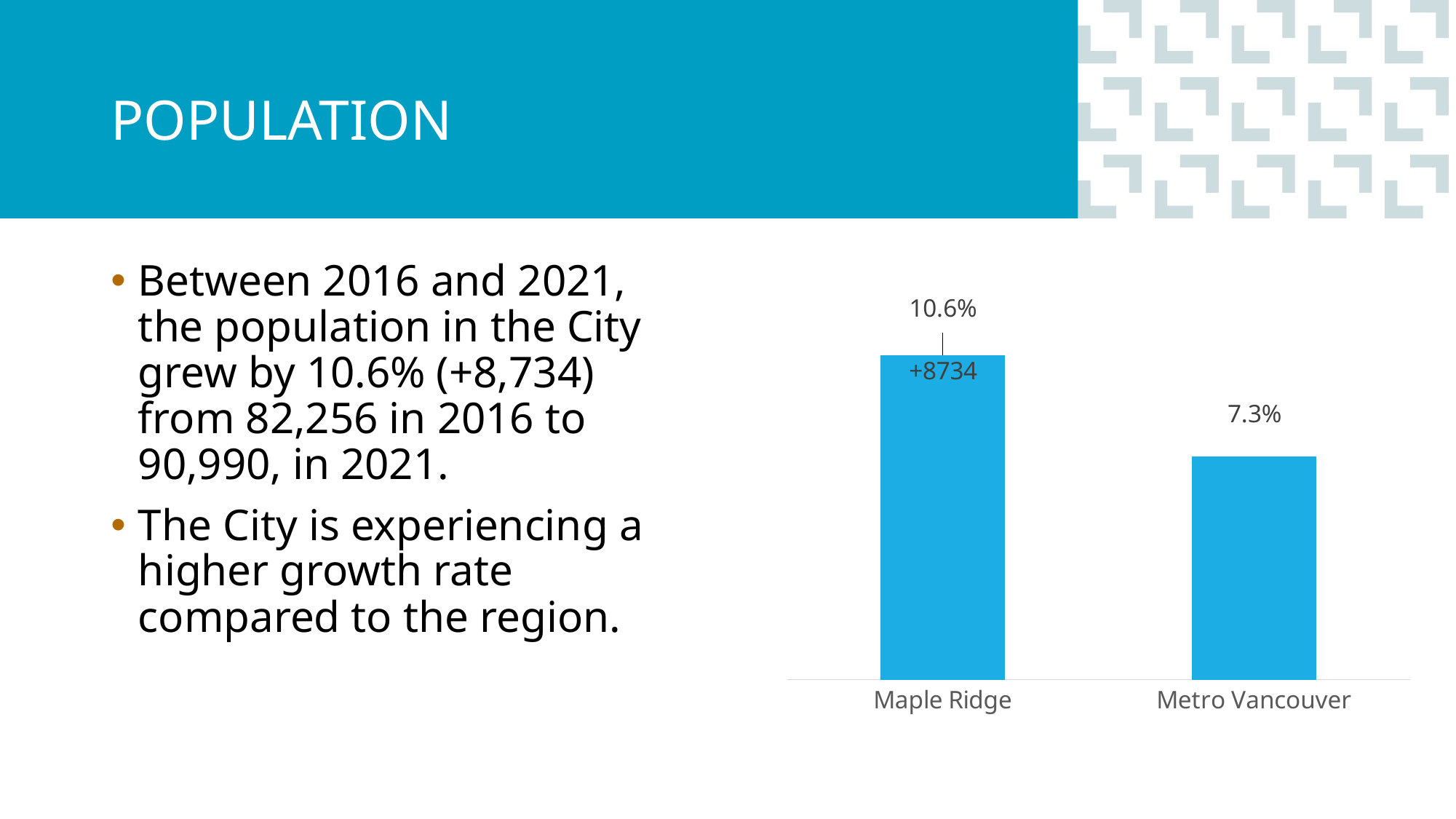
How many categories are shown in the chart? 2 What is the value shown for Metro Vancouver? 7.3% What is the value shown for Maple Ridge? 10.6% Which category has the highest value? Maple Ridge What kind of chart is shown on the slide? Bar chart What colour are the bars in the chart? Blue What annotation is printed on the Maple Ridge bar? +8734 Which is larger, the value for Maple Ridge or the value for Metro Vancouver? Maple Ridge What is the difference between the values for Maple Ridge and Metro Vancouver? 3.3% Which category has the lowest value? Metro Vancouver